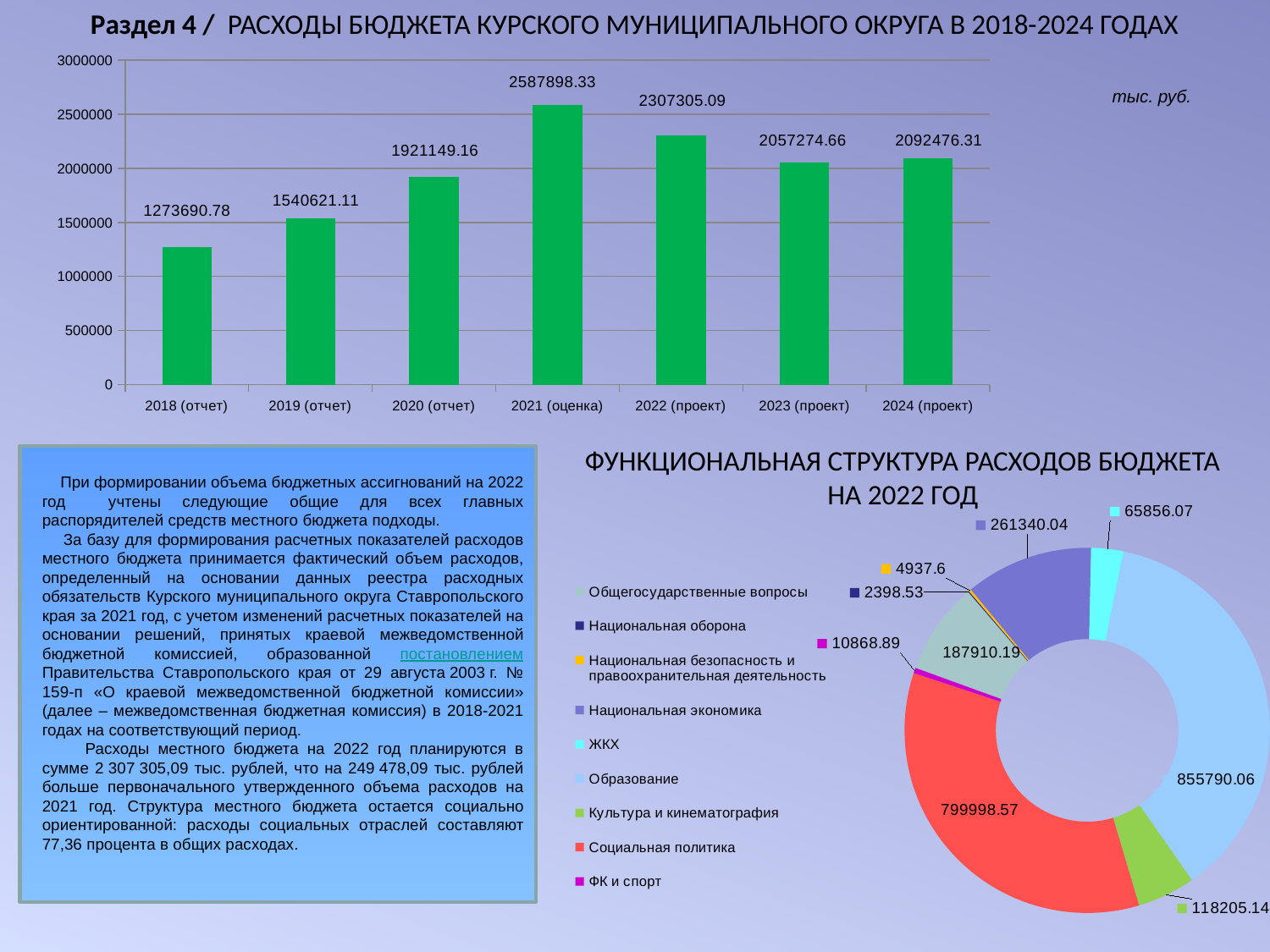
How many categories does the legend of the bottom doughnut chart 'Функциональная структура расходов бюджета на 2022 год' list? 9 In the top bar chart of budget expenditures 2018-2024, how many years are shown? 7 In the top bar chart of budget expenditures 2018-2024, what is the difference between the values for 2022 (проект) and 2023 (проект)? 250030.43 In the top bar chart of budget expenditures 2018-2024, what is the value for 2018 (отчет)? 1273690.78 In the bottom doughnut chart 'Функциональная структура расходов бюджета на 2022 год', which category has the smallest value? Национальная оборона In the bottom doughnut chart 'Функциональная структура расходов бюджета на 2022 год', what is the value for Образование? 855790.06 In the top bar chart of budget expenditures 2018-2024, do the values rise or fall from 2018 to 2021? rise In the top bar chart of budget expenditures 2018-2024, what is the value for 2021 (оценка)? 2587898.33 What kind of chart is the top chart of budget expenditures 2018-2024? bar chart In the top bar chart of budget expenditures 2018-2024, which year has the lowest value? 2018 (отчет) In the top bar chart of budget expenditures 2018-2024, which is larger: the value for 2024 (проект) or 2023 (проект)? 2024 (проект) In the top bar chart of budget expenditures 2018-2024, which year has the highest value? 2021 (оценка)